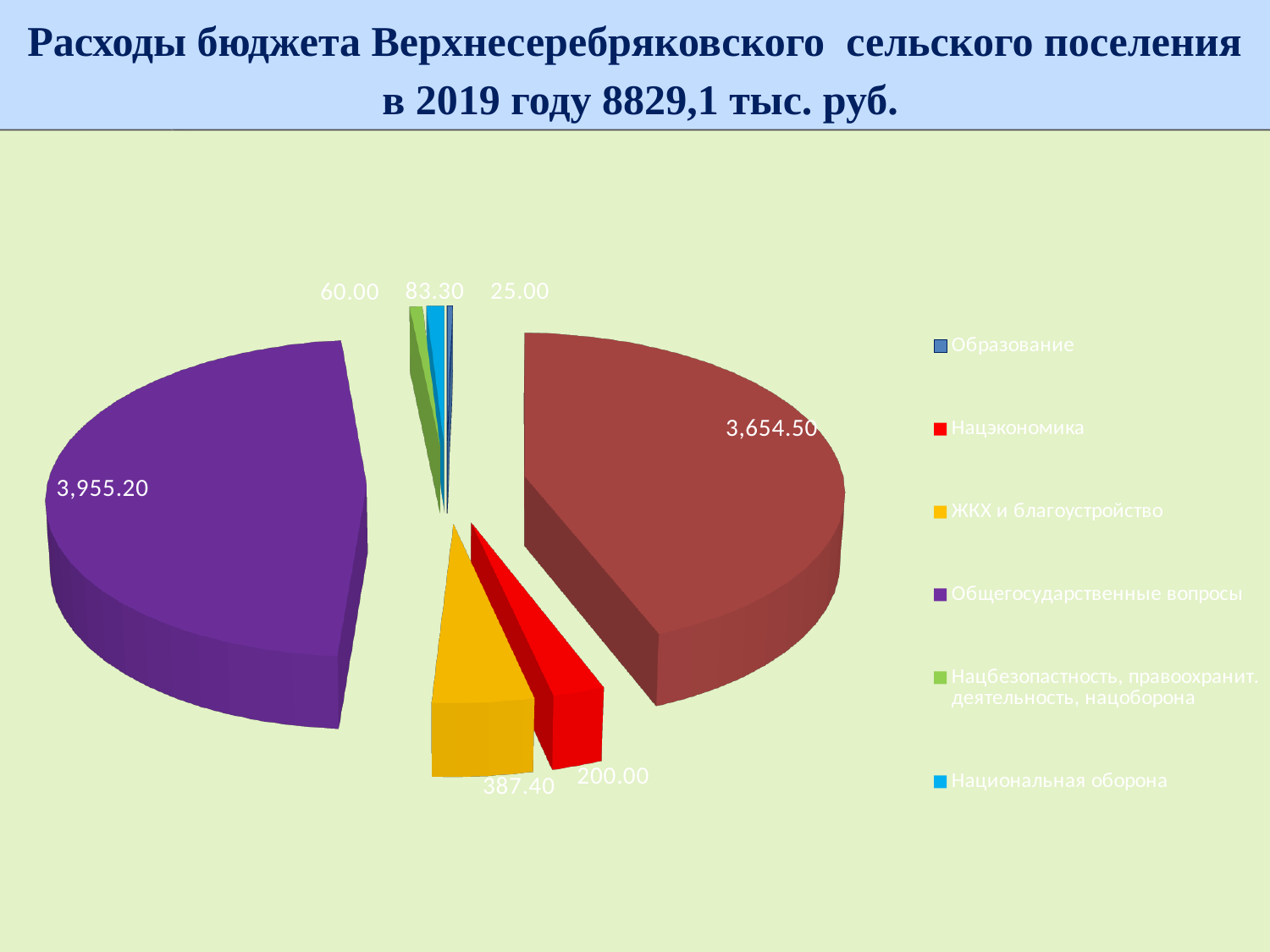
What value is shown for Национальная оборона? 83.30 What value is shown for the Общегосударственные вопросы slice? 3,955.20 What value is shown for Нацбезопастность, правоохранит. деятельность, нацоборона? 60.00 Which legend category has the largest slice in the pie chart? Общегосударственные вопросы What value is shown for Образование? 25.00 What type of chart is shown on the slide? Pie chart What is the difference between the two largest slices, labelled 3,955.20 and 3,654.50? 300.70 Which legend category has the smallest slice in the pie chart? Образование What is the difference between the values for ЖКХ и благоустройство and Нацэкономика? 187.40 What value is shown for Нацэкономика? 200.00 What value is shown for ЖКХ и благоустройство? 387.40 Which is larger, Национальная оборона or Нацбезопастность, правоохранит. деятельность, нацоборона? Национальная оборона